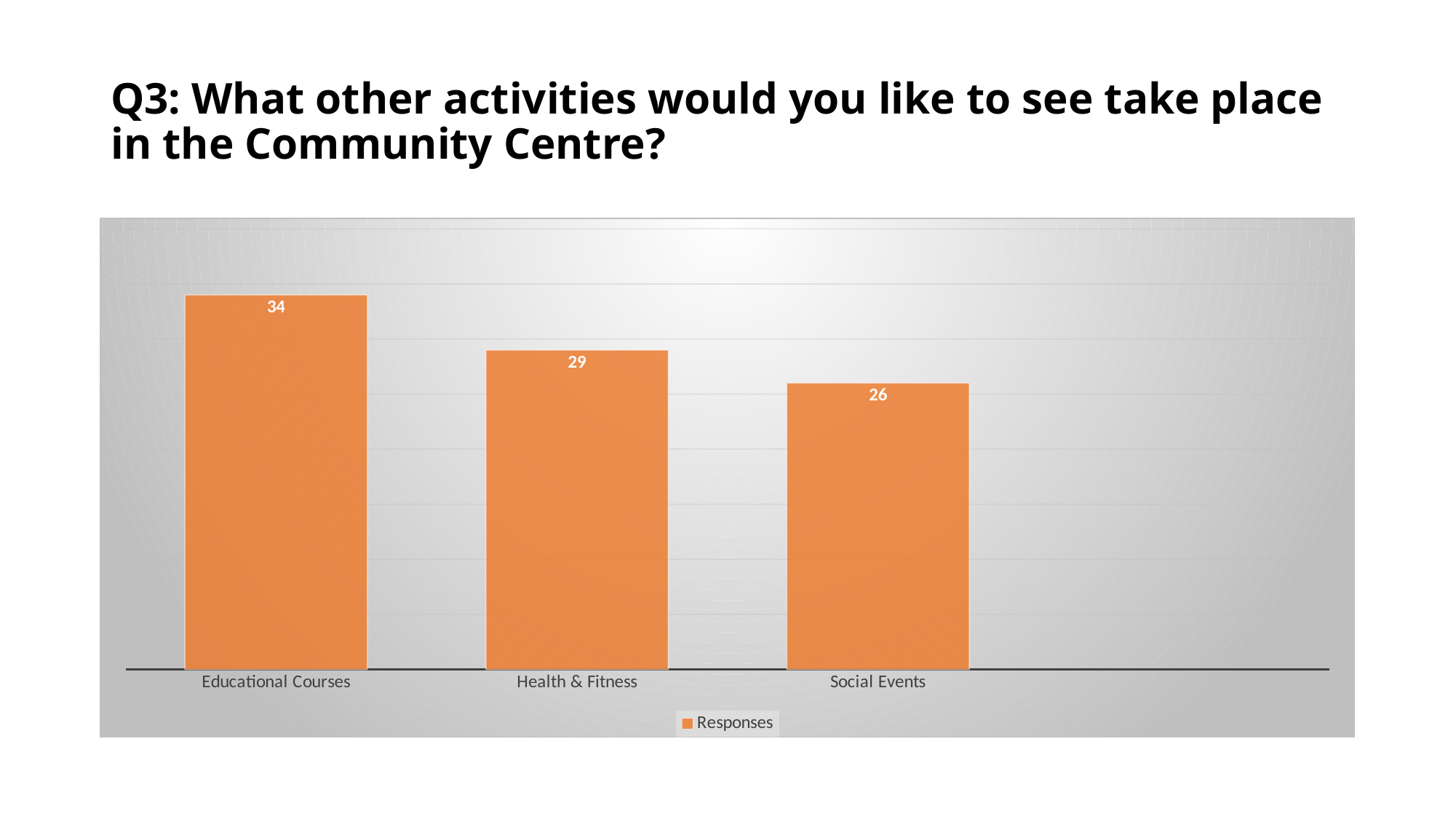
What is the number of responses for Health & Fitness? 29 Which has more responses, Health & Fitness or Social Events? Health & Fitness What is the number of responses for Educational Courses? 34 What kind of chart is shown on the slide? Bar chart How many activity categories are shown in the chart? 3 What is the difference in responses between Health & Fitness and Social Events? 3 What is the difference in responses between Educational Courses and Social Events? 8 Which activity received the fewest responses? Social Events What is the name of the series shown in the legend? Responses Which activity received the most responses? Educational Courses What is the number of responses for Social Events? 26 How many series does the legend list? 1